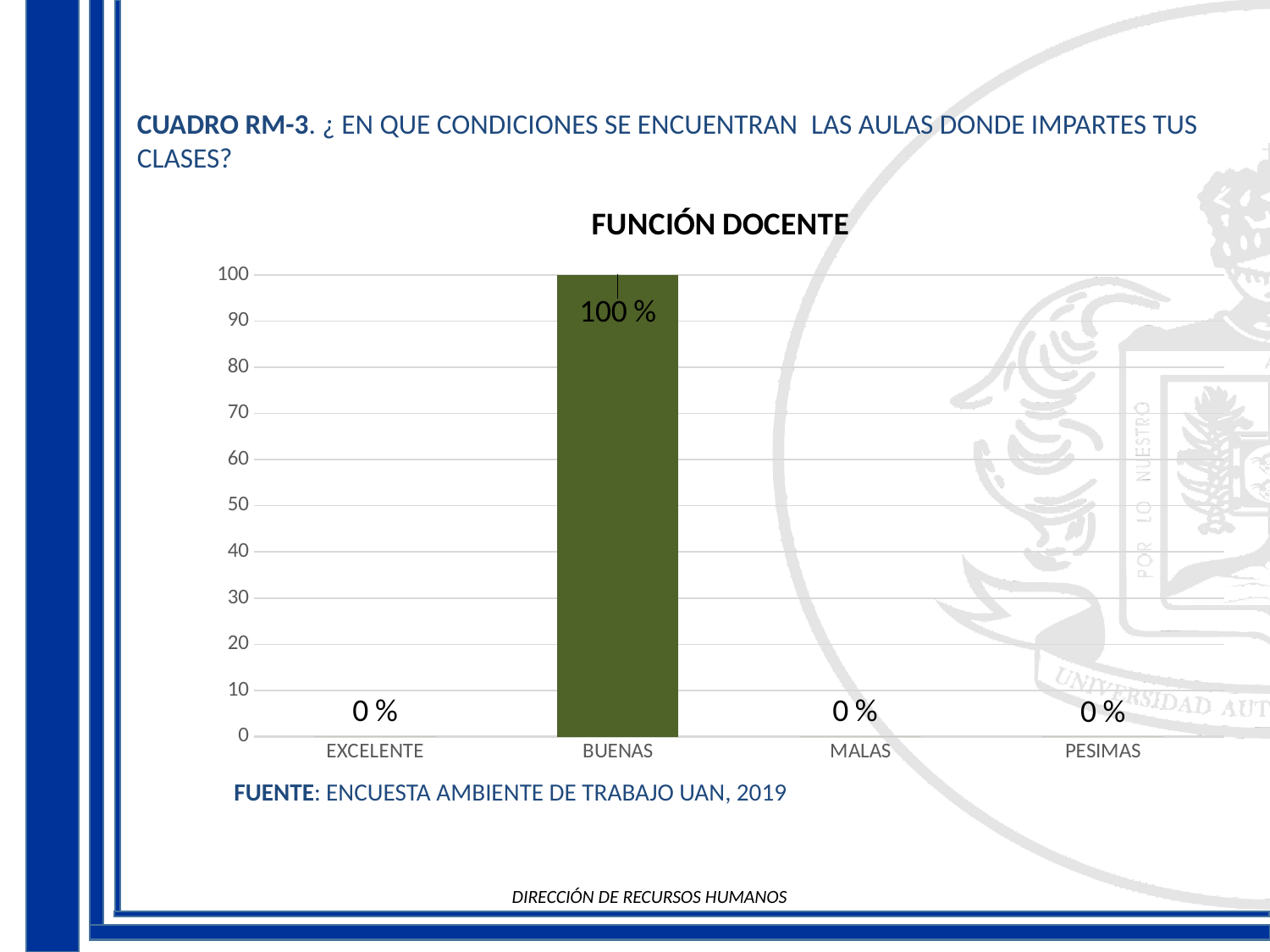
What is the value for PESIMAS? 0 % What is the value for MALAS? 0 % What is the highest value shown on the y axis? 100 What is the title of the chart? FUNCIÓN DOCENTE Is the value for BUENAS greater or less than 50? greater Which category has the highest value? BUENAS Which is larger, the value for BUENAS or the value for EXCELENTE? BUENAS What is the value for EXCELENTE? 0 % What is the value for BUENAS? 100 % What is the difference between the values for BUENAS and MALAS? 100 % How many categories are shown on the x axis? 4 What kind of chart is shown on the slide? bar chart